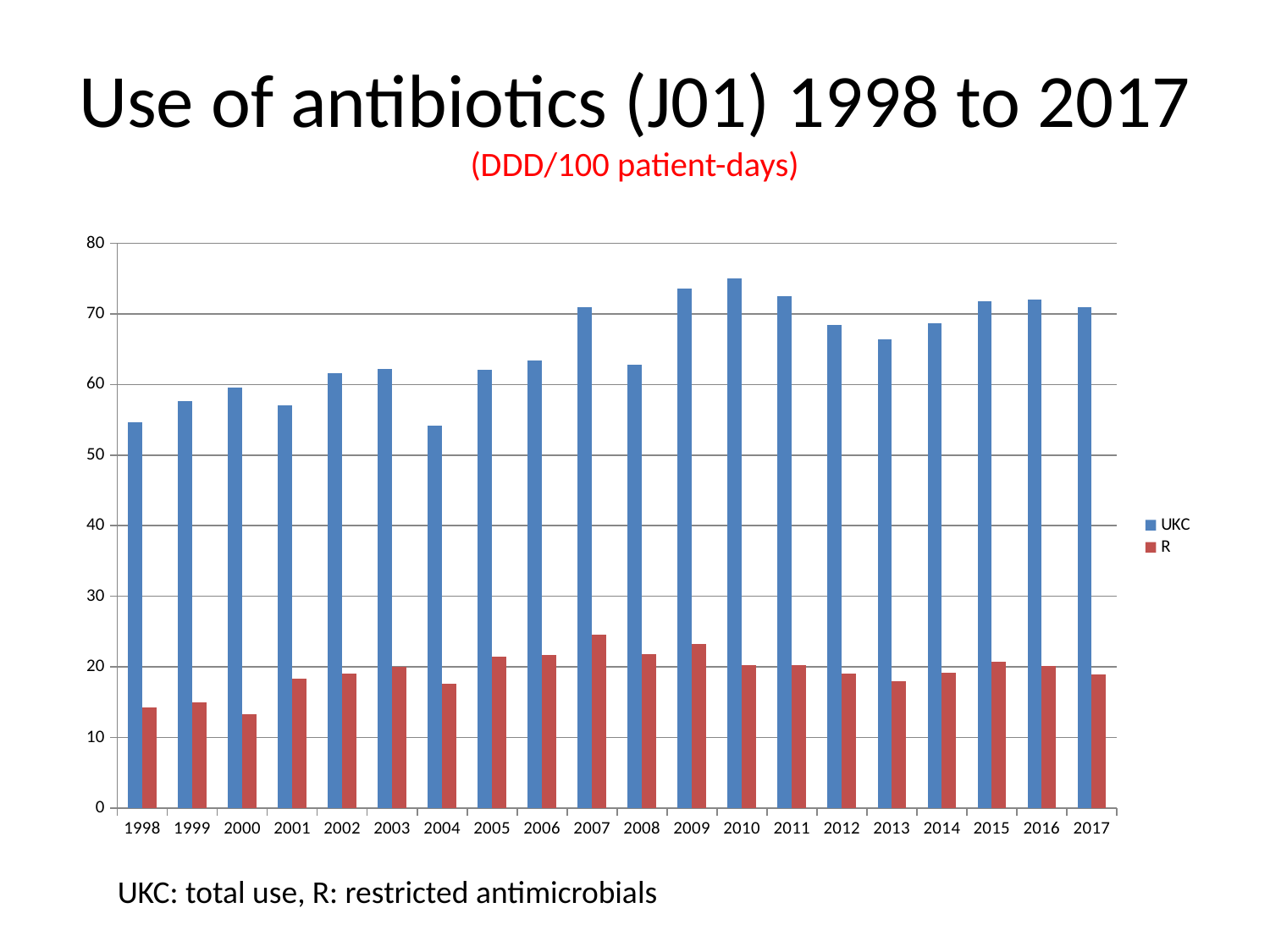
Which is larger, the UKC value for 2009 or the UKC value for 2013? 2009 Is the R value for 2007 greater or less than 20? greater What unit is given in the subtitle of the chart? DDD/100 patient-days Does the UKC value generally rise or fall from 1998 to 2010? rise What kind of chart is shown on the slide? bar chart Is the UKC value for 2010 greater or less than 70? greater Is the R value for 2000 greater or less than 20? less How many series does the legend list? 2 In which year is the R value highest? 2007 How many years are shown on the x axis? 20 In which year is the UKC value highest? 2010